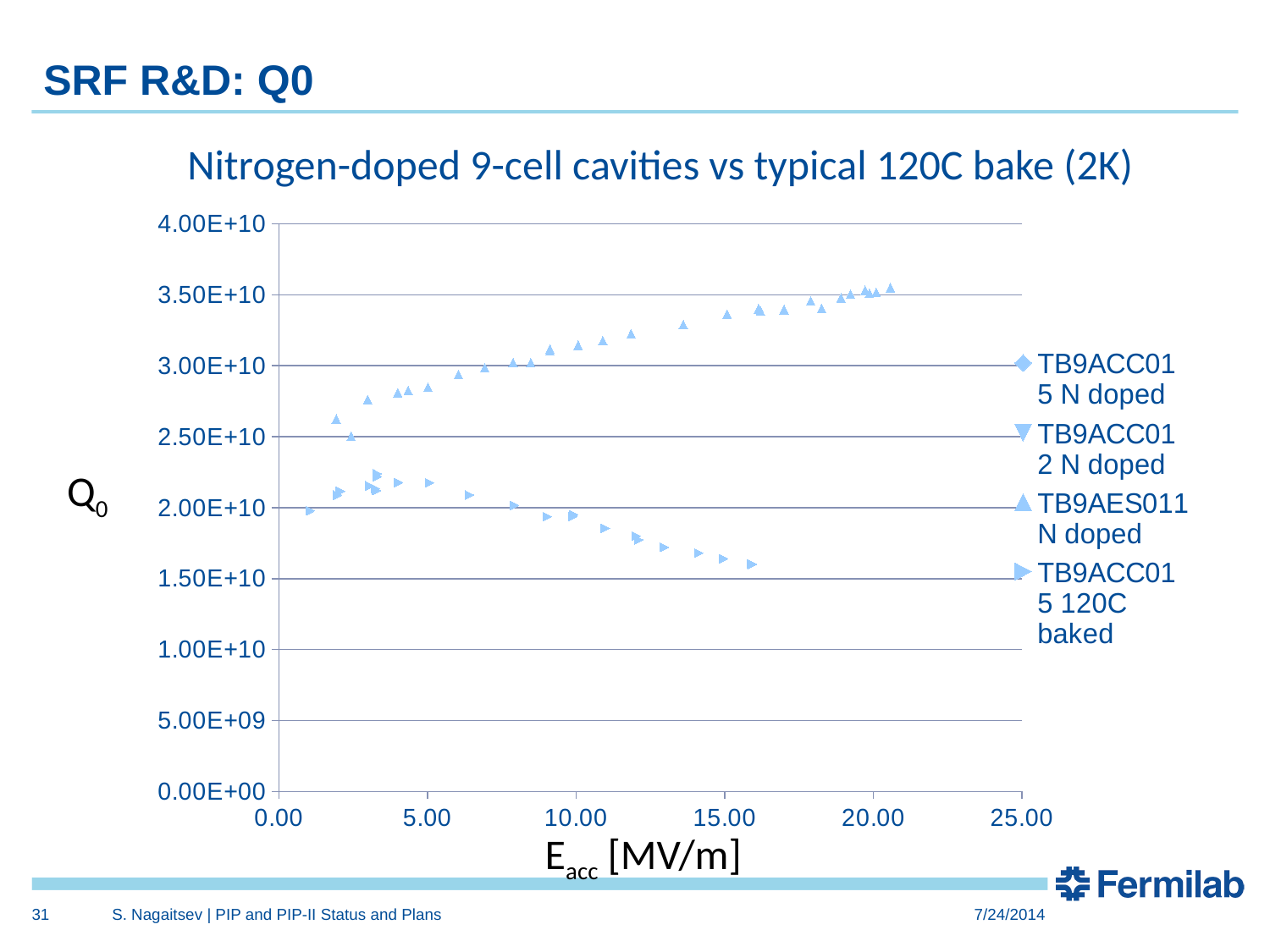
Which series has the lowest Q0 value on the chart? TB9ACC015 120C baked At 10 MV/m, which series has the higher Q0: TB9AES011 N doped or TB9ACC015 120C baked? TB9AES011 N doped Which series reaches the highest Q0 value on the chart? TB9AES011 N doped What is the label of the x axis? Eacc [MV/m] Is the Q0 value for the TB9AES011 N doped series at 5 MV/m greater or less than 2.50E+10? greater What kind of chart is shown on the slide? scatter chart How many series does the legend list? 4 Is the Q0 value for the TB9AES011 N doped series at 20 MV/m greater or less than 3.00E+10? greater Is the Q0 value for the TB9ACC015 120C baked series at 15 MV/m greater or less than 2.00E+10? less Do the values for the TB9ACC015 120C baked series rise or fall as Eacc increases beyond 5 MV/m? fall What is the title of the chart? Nitrogen-doped 9-cell cavities vs typical 120C bake (2K) Do the values for the TB9AES011 N doped series rise or fall as Eacc increases? rise